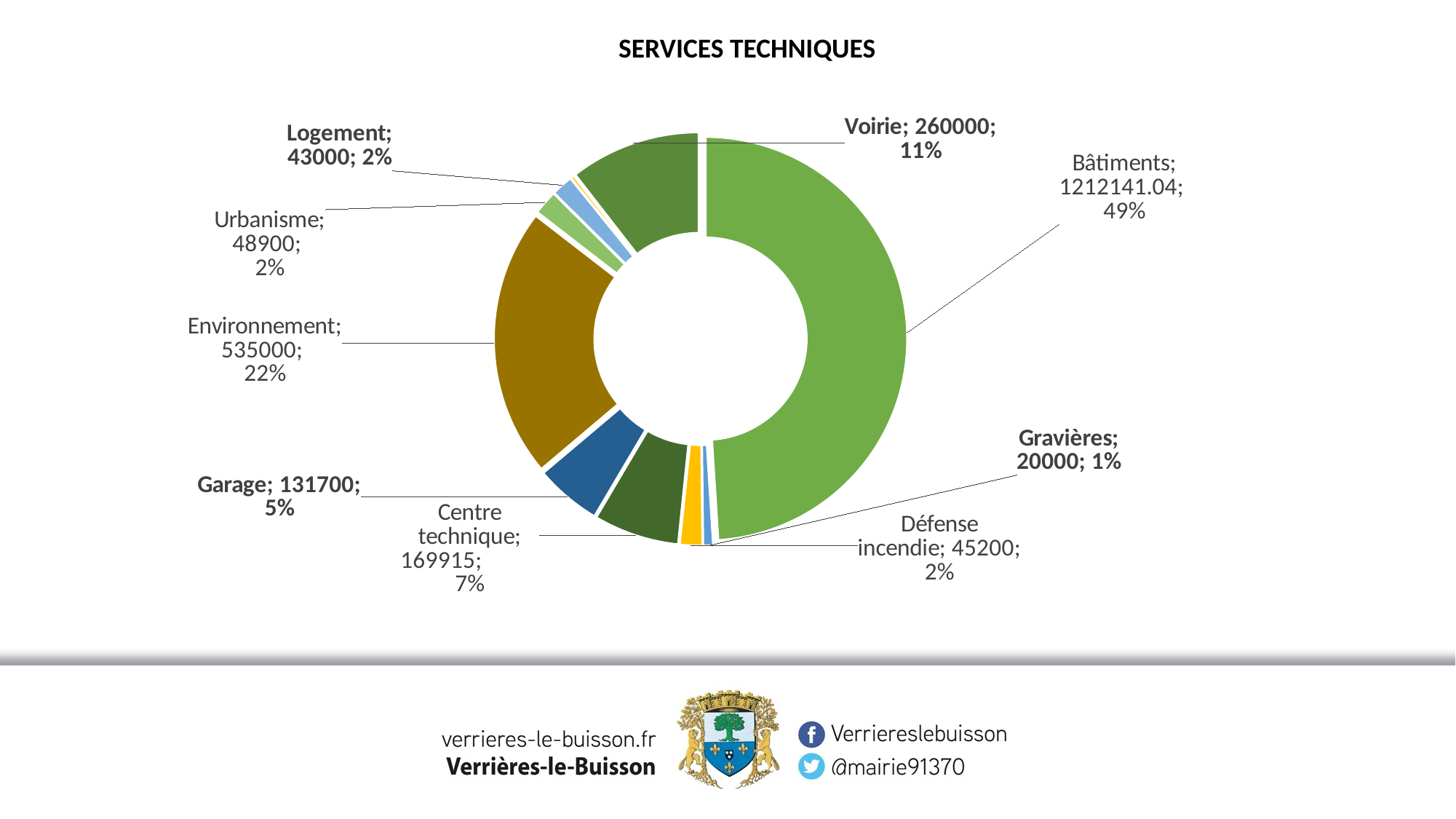
What is the value for Bâtiments? 1212141.04 What is the value for Centre technique? 169915 What share of the chart does Voirie represent? 11% Which category has the largest value? Bâtiments Which is larger, the value for Garage or the value for Centre technique? Centre technique How many categories are shown in the chart? 10 What is the value for Environnement? 535000 What is the difference between the values for Environnement and Voirie? 275000 What kind of chart is shown on the slide? Doughnut chart What share of the chart does Garage represent? 5% What is the title of the chart? SERVICES TECHNIQUES